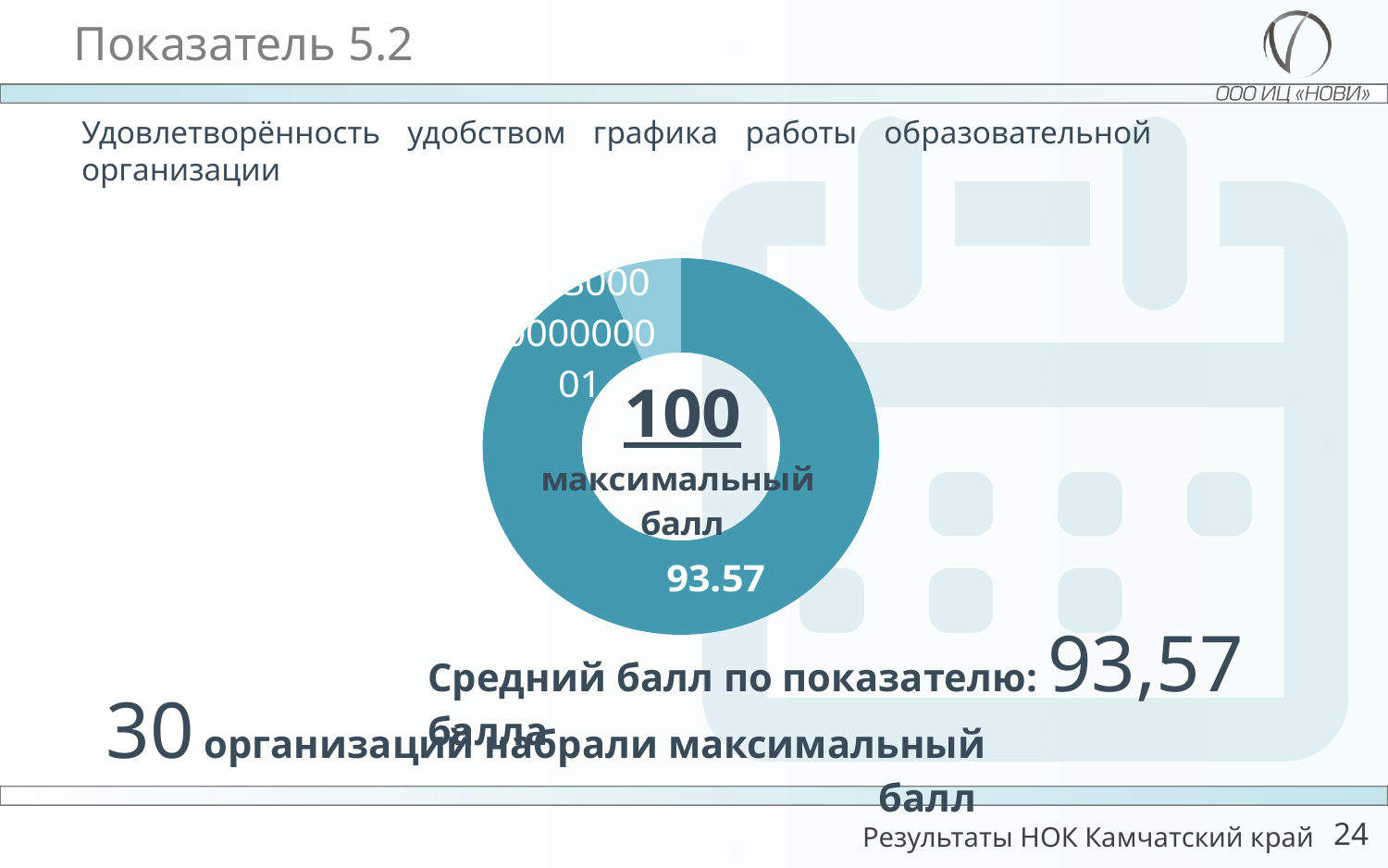
Which slice of the donut chart is larger, the dark teal one or the light blue one? The dark teal one What kind of chart is shown on the slide? Pie (donut) chart What text accompanies the number in the centre of the donut chart? максимальный балл Is the value of the dark teal slice greater or less than 50? greater How many slices does the donut chart have? 2 What number is printed in the centre of the donut chart? 100 What is the value of the largest slice in the donut chart? 93.57 What value is printed on the large dark teal slice of the donut chart? 93.57